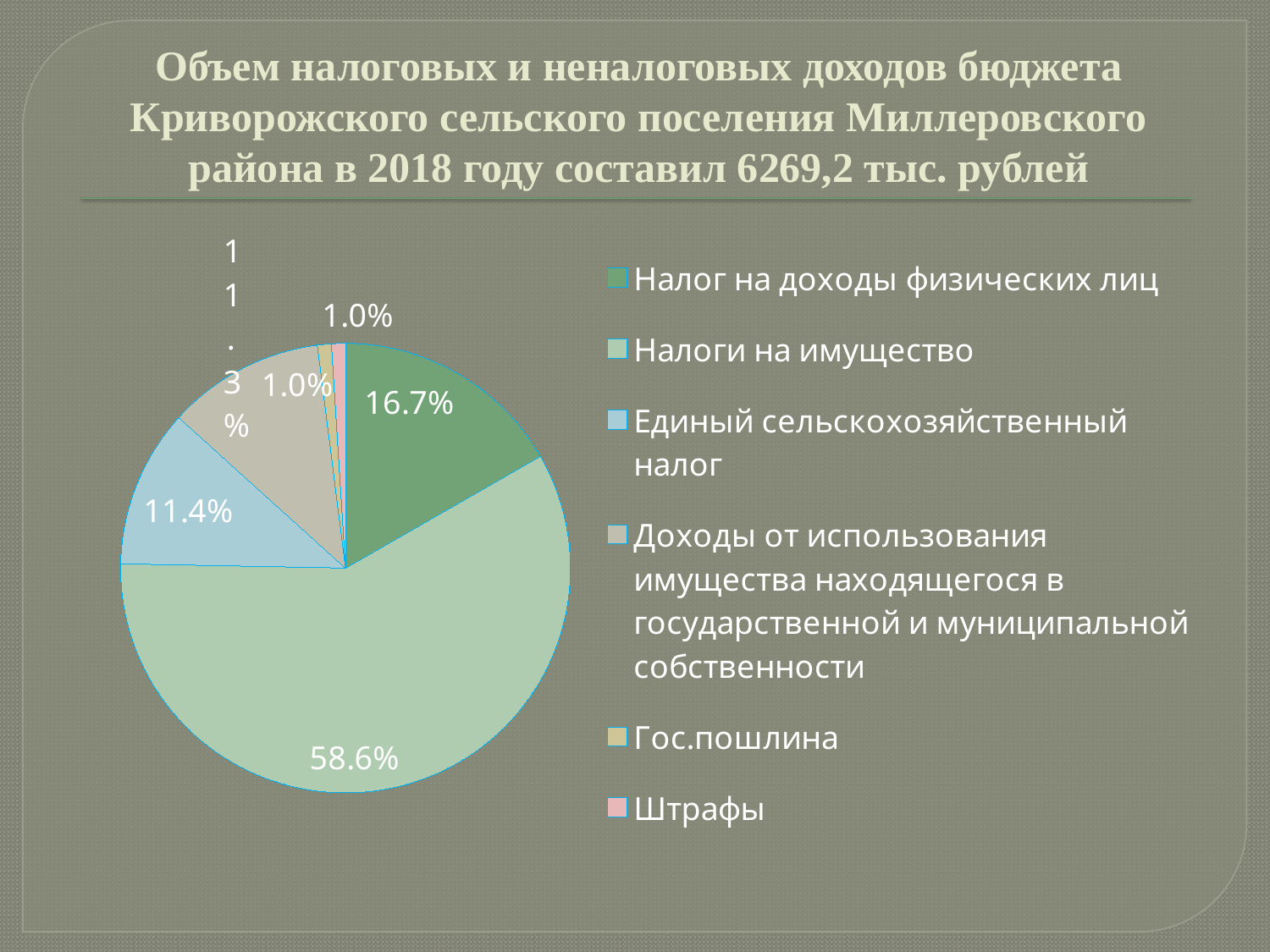
Which is larger: the share of Налог на доходы физических лиц or the share of Единый сельскохозяйственный налог? Налог на доходы физических лиц What share of the pie does Штрафы have? 1.0% What share of the pie does Налоги на имущество have? 58.6% According to the slide title, what was the total volume of tax and non-tax budget revenues in 2018? 6269,2 тыс. рублей What share of the pie does Единый сельскохозяйственный налог have? 11.4% Which category has the largest share of the pie? Налоги на имущество What is the smallest share shown on the pie chart? 1.0% What is the difference between the shares of Налоги на имущество and Налог на доходы физических лиц? 41.9% What kind of chart is shown on the slide? pie chart How many slices does the pie chart have? 6 How many entries does the legend list? 6